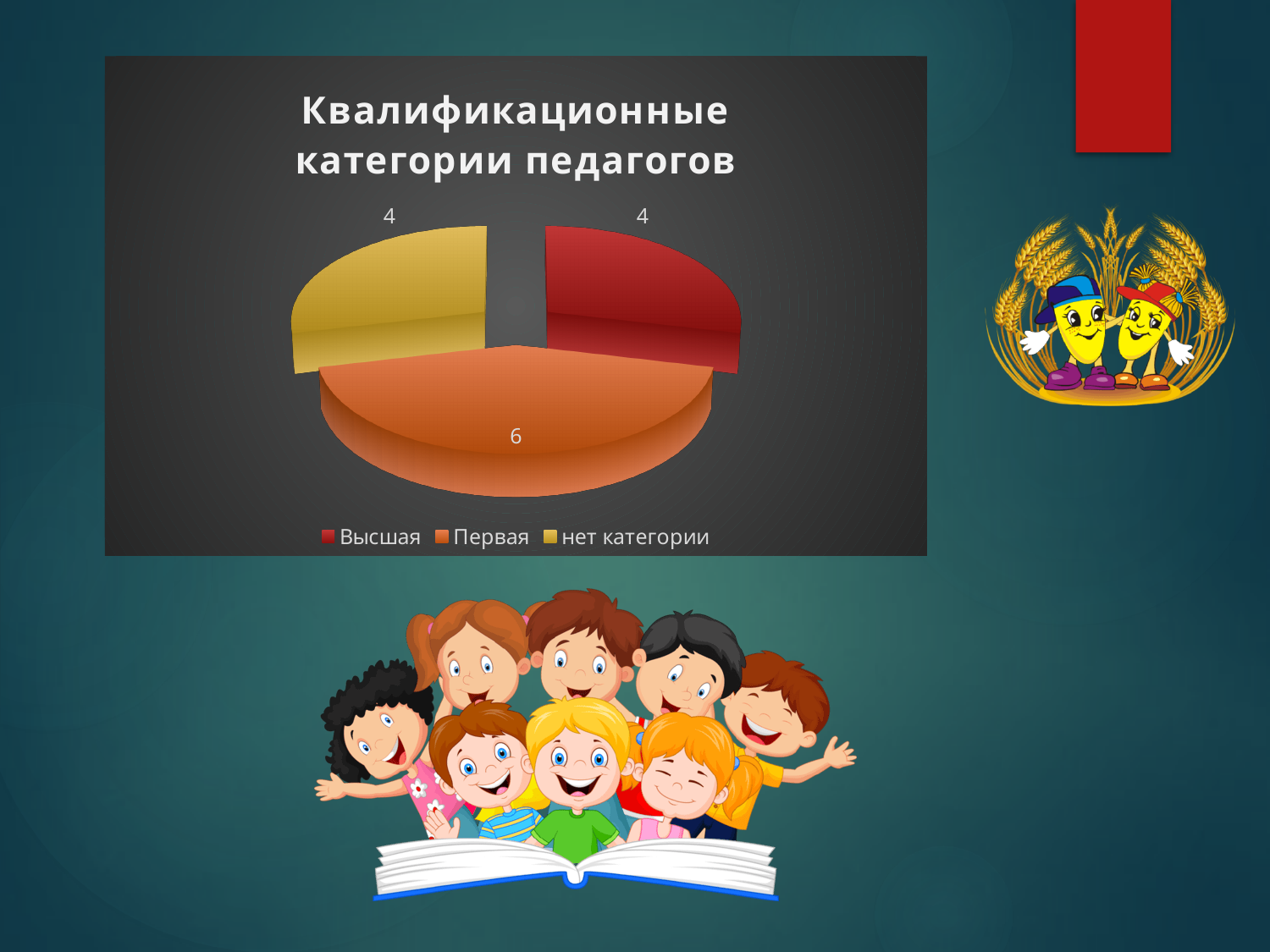
What is the value for нет категории in the pie chart? 4 Which category has the largest slice in the pie chart? Первая What is the value for Высшая in the pie chart? 4 What is the title of the chart? Квалификационные категории педагогов Which colour represents Высшая in the pie chart? Red What kind of chart is shown on the slide? Pie chart How many categories does the pie chart show? 3 Which is larger, the value for Первая or the value for нет категории? Первая What is the total of all slices in the pie chart? 14 What is the value for Первая in the pie chart? 6 What is the difference between the values for Первая and Высшая? 2